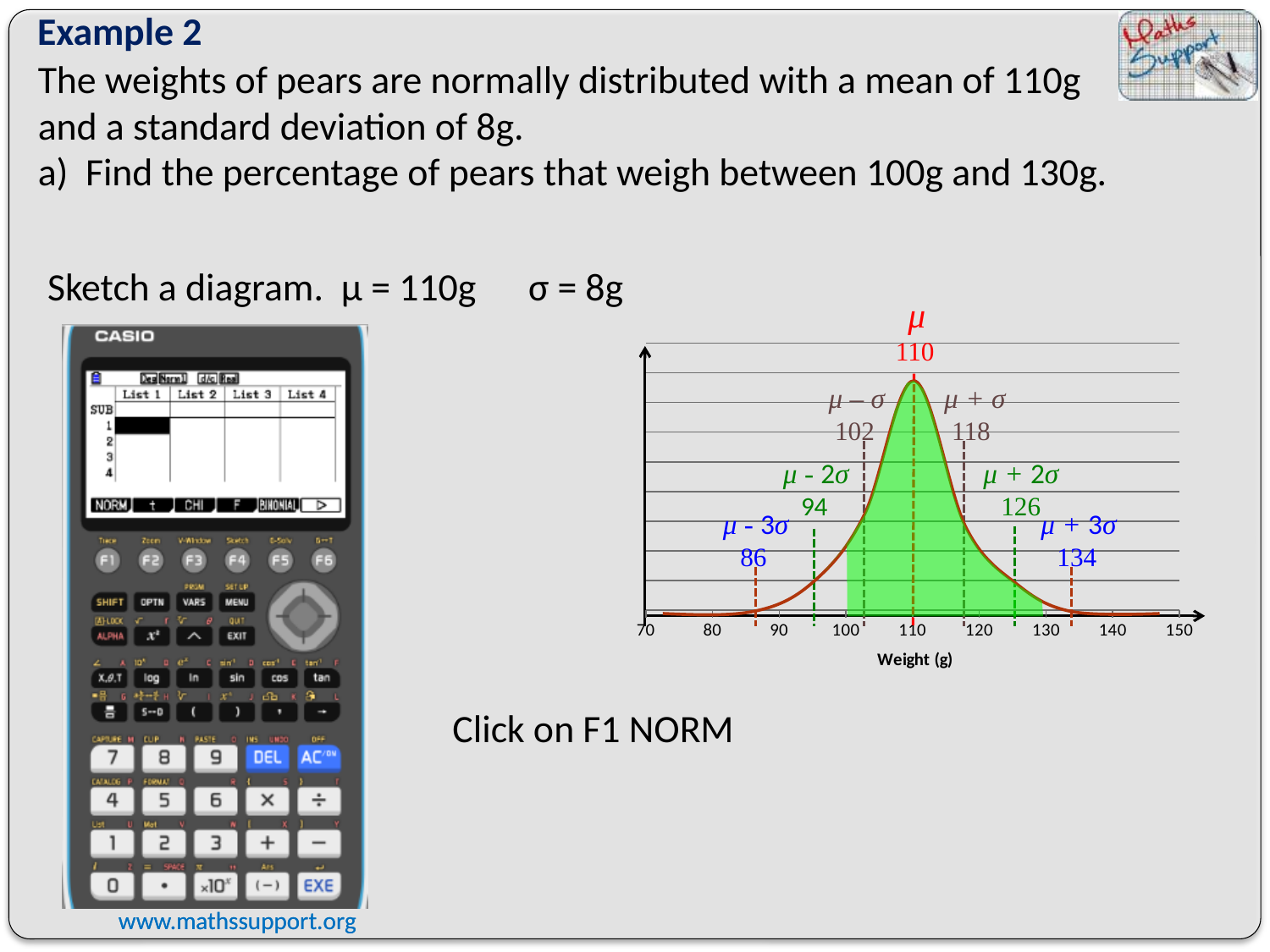
What value is labelled at μ − σ on the chart? 102 What is the difference between the values labelled at μ + σ and μ − σ on the chart? 16 What value is labelled at μ + σ on the chart? 118 What is the x-axis title of the chart on the slide? Weight (g) What value is labelled at μ − 2σ on the chart? 94 What is the difference between the values labelled at μ + 3σ and μ − 3σ on the chart? 48 What value is labelled at μ + 2σ on the chart? 126 Between which two x-axis values is the green shaded region of the chart? 100 and 130 What value is labelled at μ − 3σ on the chart? 86 What value is labelled at μ + 3σ on the chart? 134 What value is labelled at μ on the chart? 110 What is the lowest value shown on the x-axis of the chart? 70